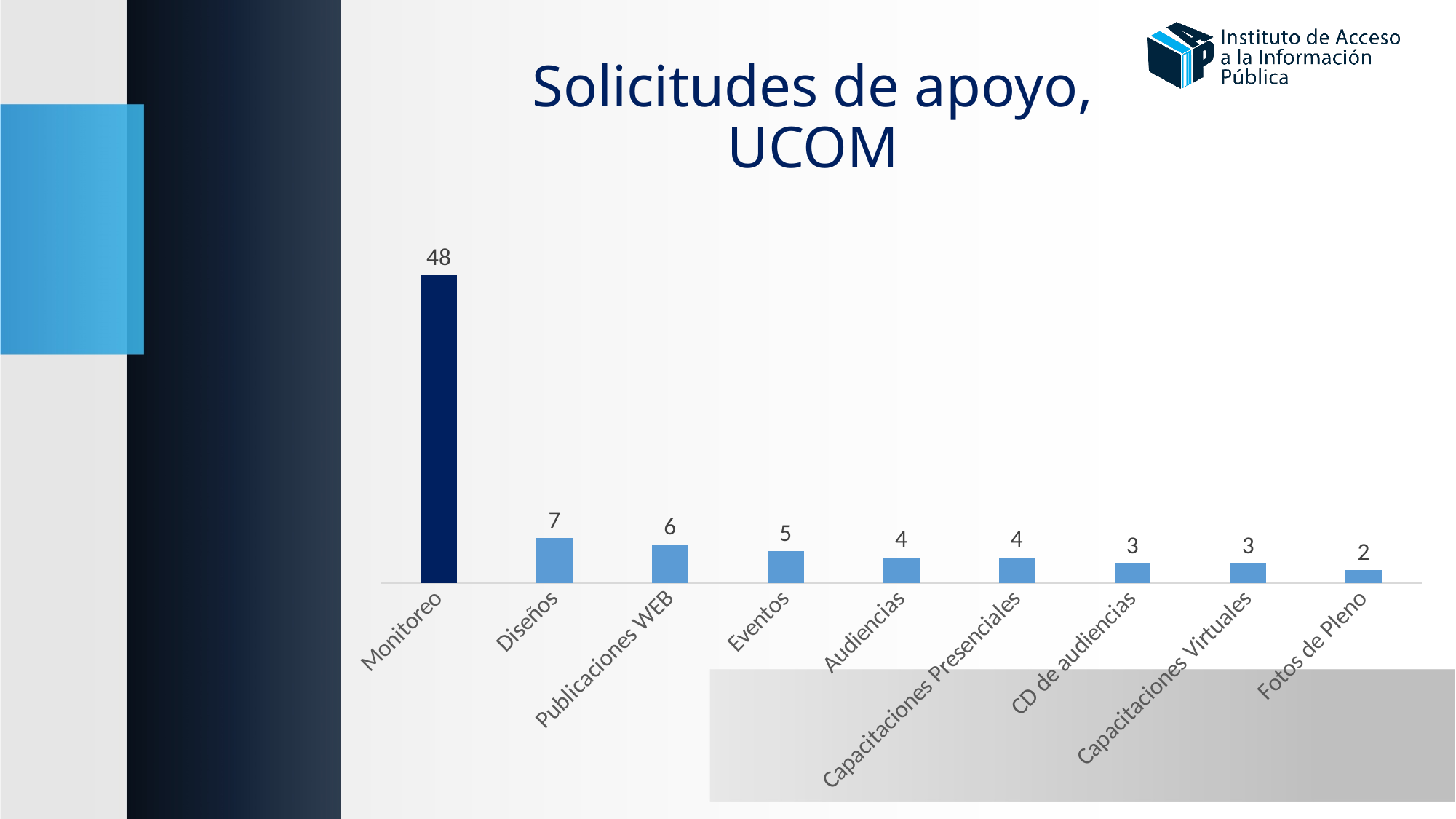
What is the value for Fotos de Pleno? 2 Which category has the highest value? Monitoreo What is the title of the slide? Solicitudes de apoyo, UCOM What kind of chart is shown on the slide? Bar chart What is the value for Monitoreo? 48 What is the difference between the values for Monitoreo and Diseños? 41 What is the value for Capacitaciones Virtuales? 3 Which is larger, the value for Diseños or the value for Eventos? Diseños What is the value for Publicaciones WEB? 6 How many categories are shown in the chart? 9 What is the difference between the values for Eventos and Fotos de Pleno? 3 Which category has the lowest value? Fotos de Pleno